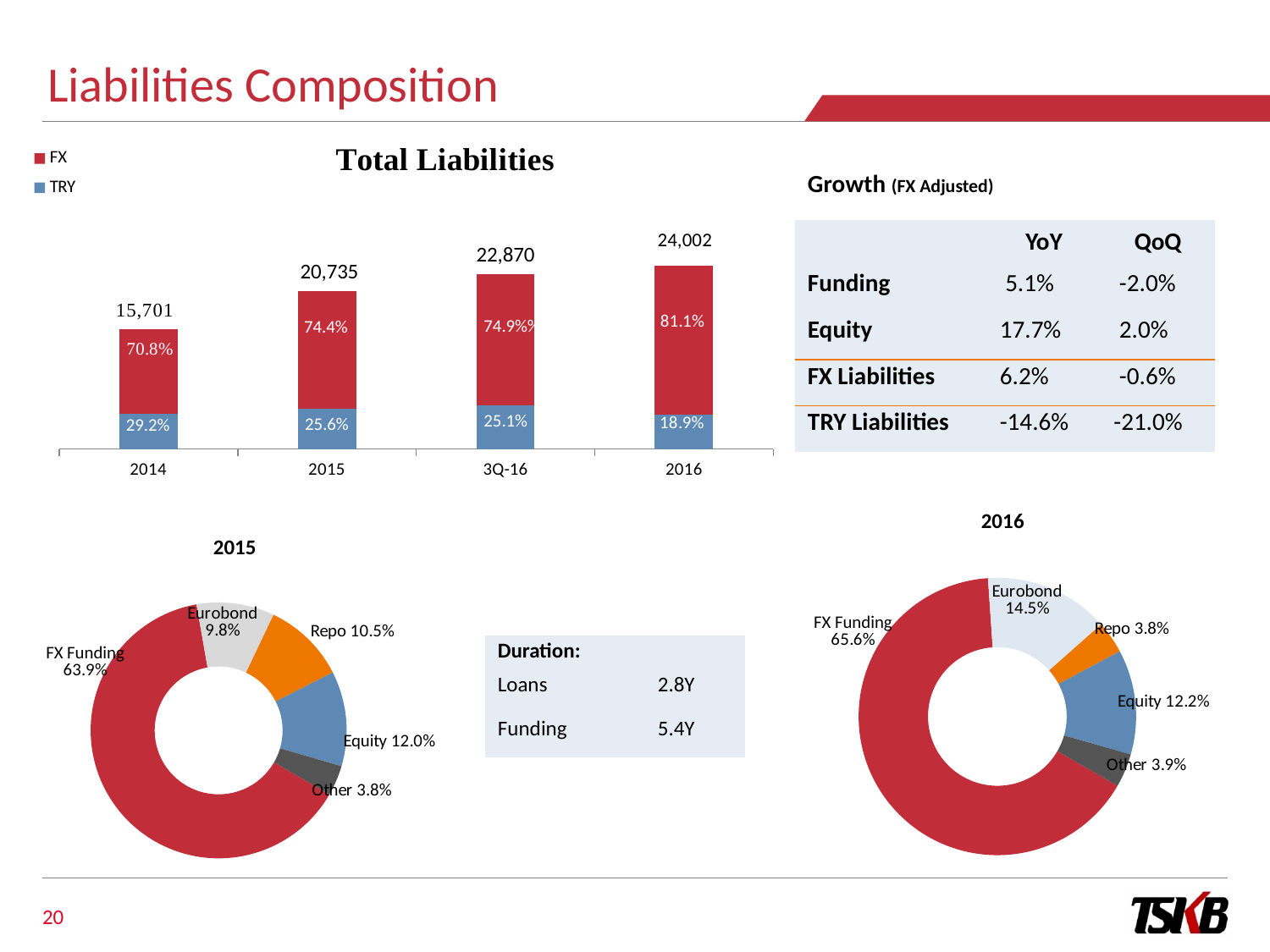
In the Total Liabilities chart, how many periods are shown on the x axis? 4 In the Total Liabilities chart, what is the total liabilities value for 2016? 24,002 In the Total Liabilities chart, what is the difference between the total liabilities for 2016 and 2015? 3,267 In the 2016 pie chart, which category has the largest share? FX Funding In the 2015 pie chart, what share does Repo have? 10.5% In the Total Liabilities chart, how many series does the legend list? 2 In the Total Liabilities chart, does the TRY share rise or fall from 2014 to 2016? fall In the Total Liabilities chart, which period has the lowest total liabilities? 2014 In the Total Liabilities chart, what is the FX share for 2014? 70.8% What kind of chart is the Total Liabilities chart? stacked bar chart Is the Eurobond share larger in the 2015 pie chart or the 2016 pie chart? 2016 In the Total Liabilities chart, what is the TRY share for 3Q-16? 25.1%